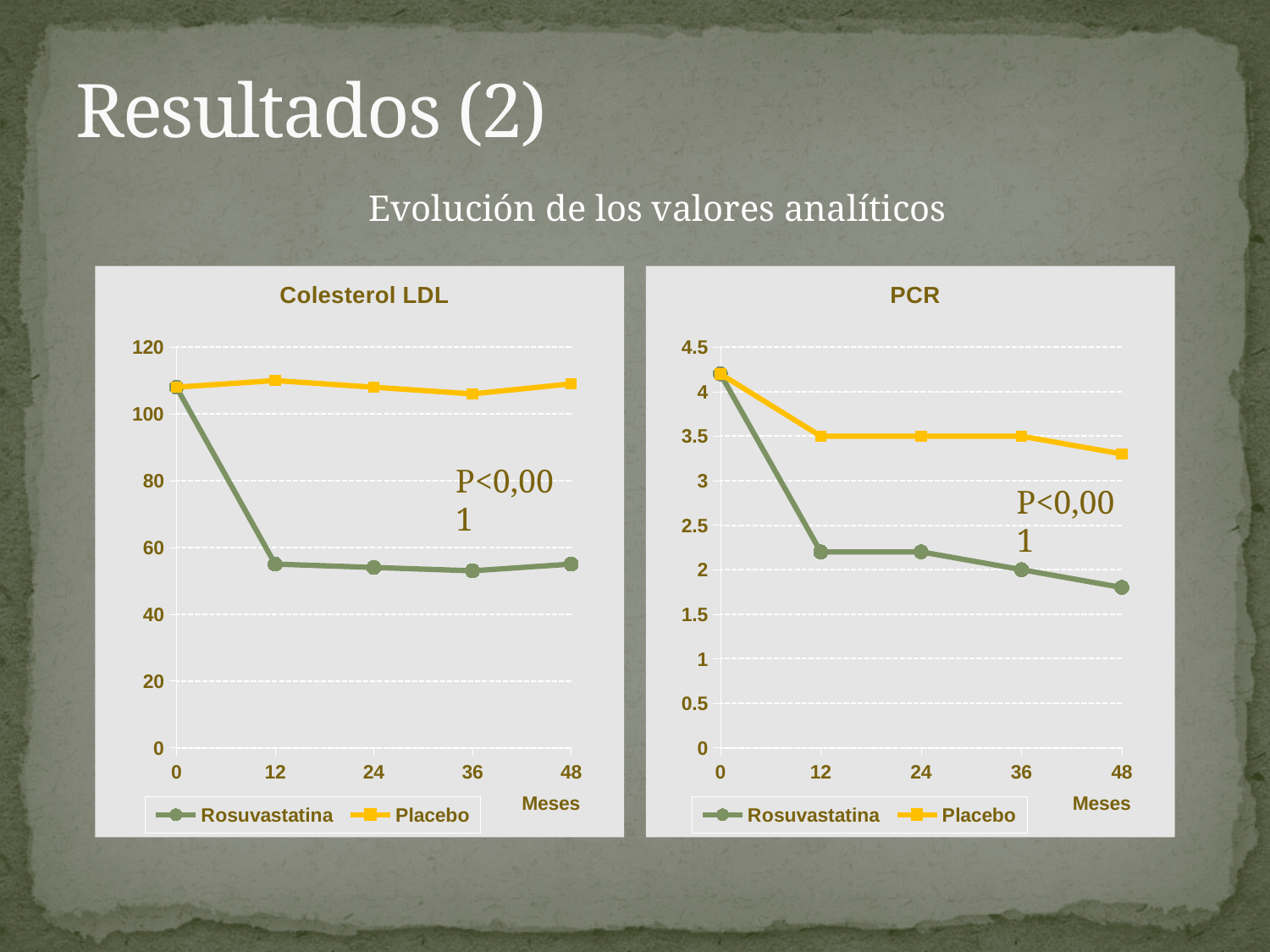
In the PCR chart, what is the Rosuvastatina value at 36 months? 2 In the Colesterol LDL chart, which series has the higher value at 36 months, Rosuvastatina or Placebo? Placebo In the PCR chart, is the Rosuvastatina value at 48 months greater or less than 2? less What is the title of the chart on the right side of the slide? PCR What kind of chart is the Colesterol LDL chart? line chart In the Colesterol LDL chart, does the Rosuvastatina series rise or fall between 0 and 12 months? fall In the Colesterol LDL chart, is the Placebo value at 48 months greater or less than 100? greater How many series does the legend of the PCR chart list? 2 How many time points are plotted along the x axis of the Colesterol LDL chart? 5 In the PCR chart, which series has the lower value at 24 months, Rosuvastatina or Placebo? Rosuvastatina In the PCR chart, what is the Placebo value at 12 months? 3.5 In the Colesterol LDL chart, is the Rosuvastatina value at 12 months greater or less than 60? less